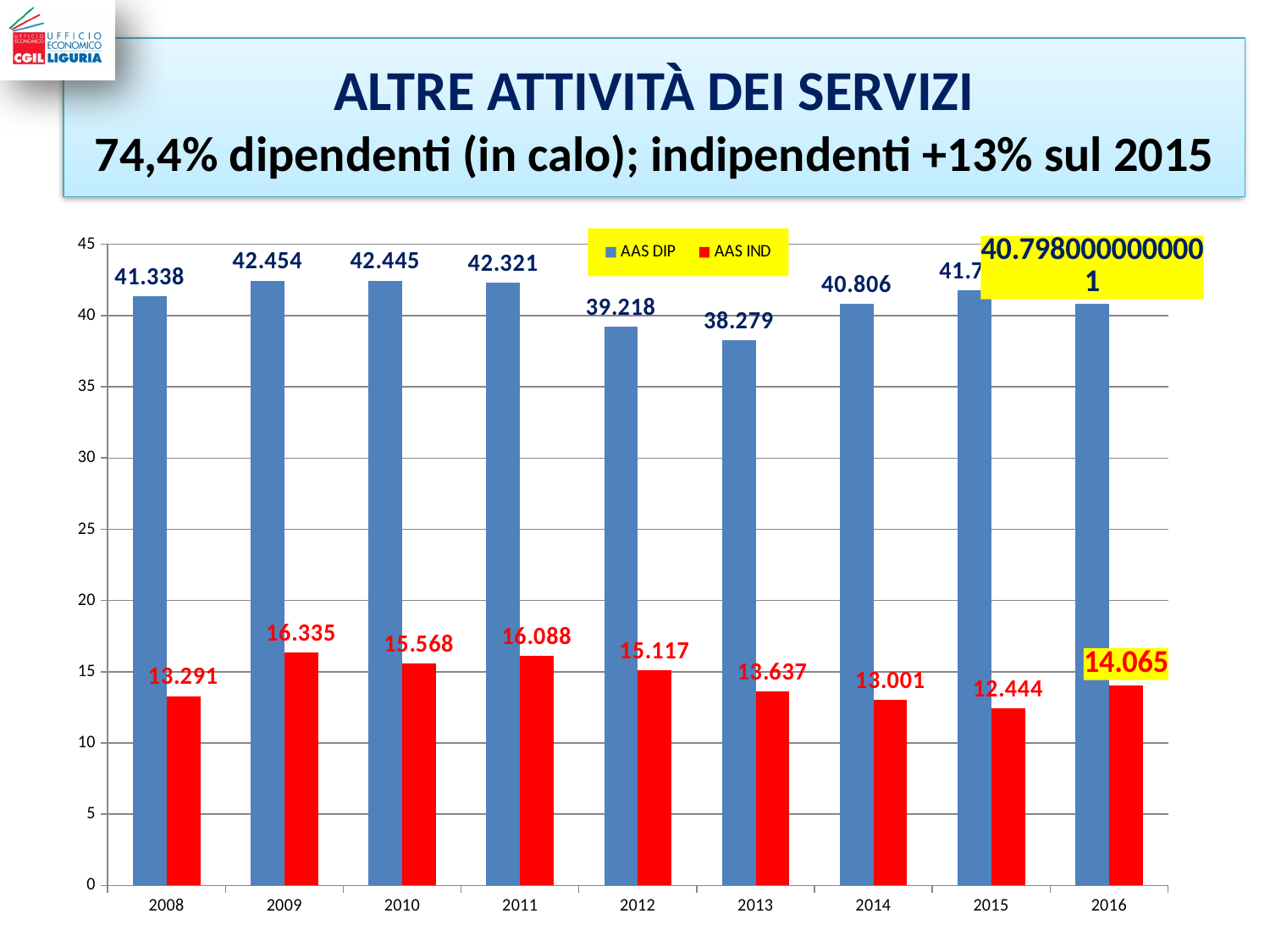
What is the value of AAS IND in 2016? 14.065 What is the value of AAS IND in 2011? 16.088 In which year is AAS IND lowest? 2015 How many series does the legend list? 2 In which year is AAS DIP lowest? 2013 What kind of chart is shown on the slide? bar chart Is the value for AAS DIP in 2012 greater or less than 35? greater Which is larger, AAS DIP in 2012 or AAS DIP in 2013? AAS DIP in 2012 What is the difference between AAS IND in 2009 and AAS IND in 2008? 3.044 What is the value of AAS DIP in 2013? 38.279 How many years are shown on the x axis? 9 What is the value of AAS DIP in 2008? 41.338